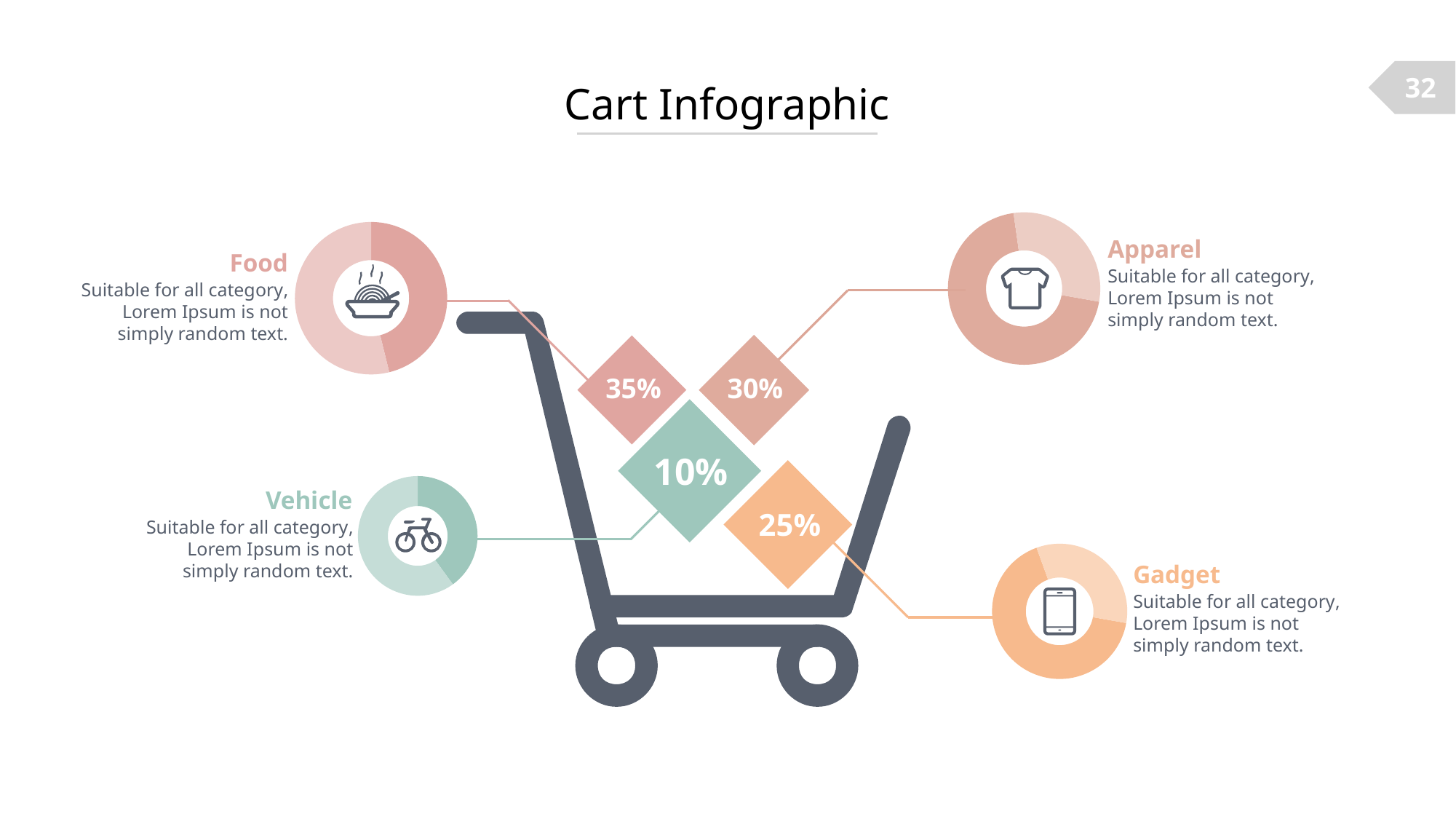
What is the difference between the Gadget and Vehicle percentages? 15% What percentage is shown for Gadget? 25% Which category has the lowest percentage? Vehicle What is the title of the slide? Cart Infographic Which category has the highest percentage? Food What is the total of the four percentages shown? 100% What percentage is shown for Vehicle? 10% What is the difference between the Food and Apparel percentages? 5% What percentage is shown for Food? 35% Which is larger, the percentage for Apparel or for Gadget? Apparel What percentage is shown for Apparel? 30% How many categories are shown in the infographic? 4